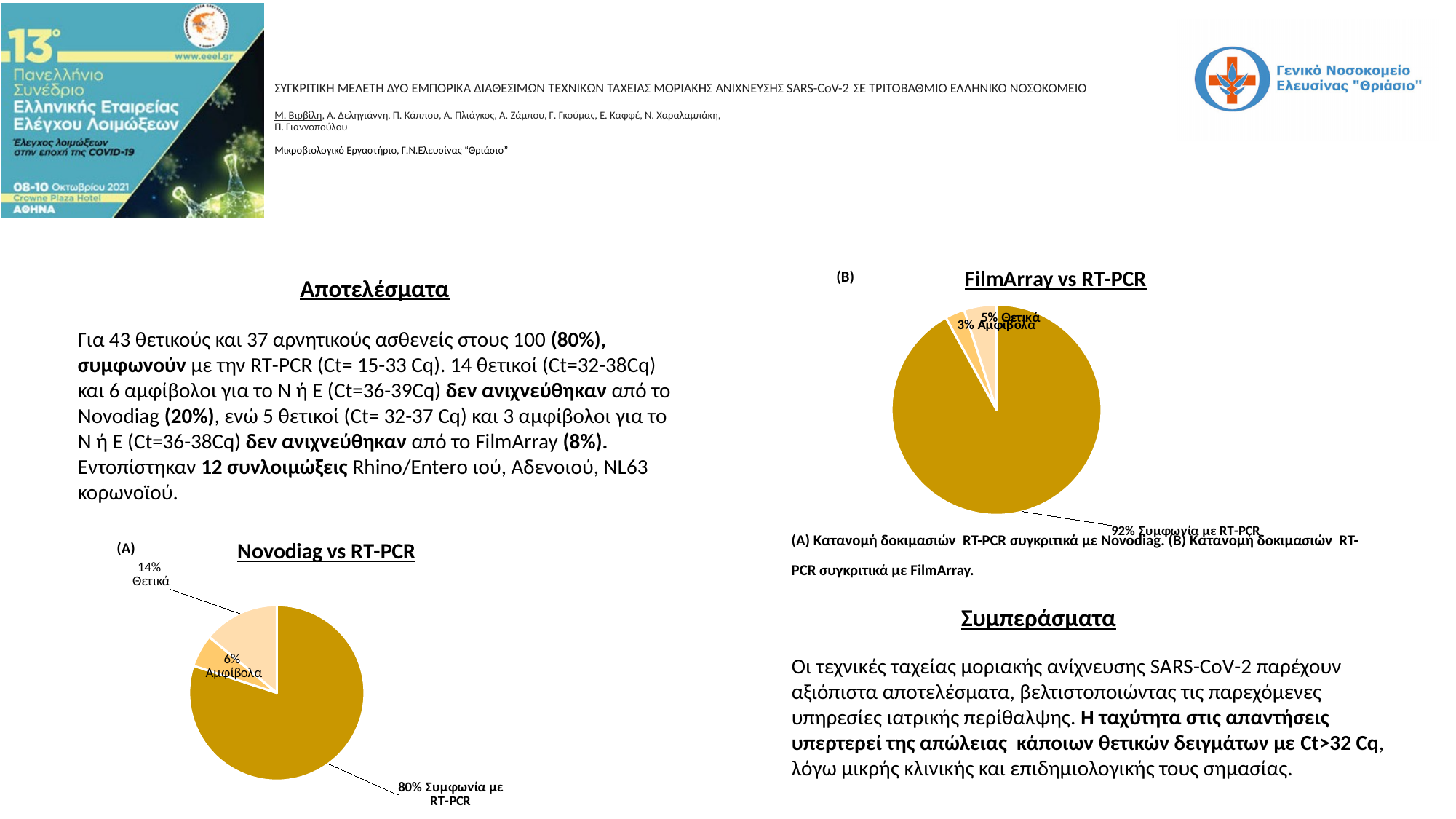
Which chart shows a larger 'Συμφωνία με RT-PCR' share, 'Novodiag vs RT-PCR' or 'FilmArray vs RT-PCR'? FilmArray vs RT-PCR In the 'Novodiag vs RT-PCR' chart, what percentage is shown for 'Θετικά'? 14% In the 'FilmArray vs RT-PCR' chart, what share of the pie is labelled 'Συμφωνία με RT-PCR'? 92% In the 'Novodiag vs RT-PCR' chart, which slice is the largest? Συμφωνία με RT-PCR What type of chart is 'Novodiag vs RT-PCR'? Pie chart In the 'FilmArray vs RT-PCR' chart, what percentage is shown for 'Θετικά'? 5% In the 'FilmArray vs RT-PCR' chart, what percentage is shown for 'Αμφίβολα'? 3% In the 'Novodiag vs RT-PCR' chart, what is the difference between the 'Θετικά' and 'Αμφίβολα' percentages? 8% In the 'Novodiag vs RT-PCR' chart, what share of the pie is labelled 'Συμφωνία με RT-PCR'? 80% In the 'Novodiag vs RT-PCR' chart, what percentage is shown for 'Αμφίβολα'? 6% How many slices does the 'FilmArray vs RT-PCR' pie chart have? 3 In the 'FilmArray vs RT-PCR' chart, which slice is the smallest? Αμφίβολα